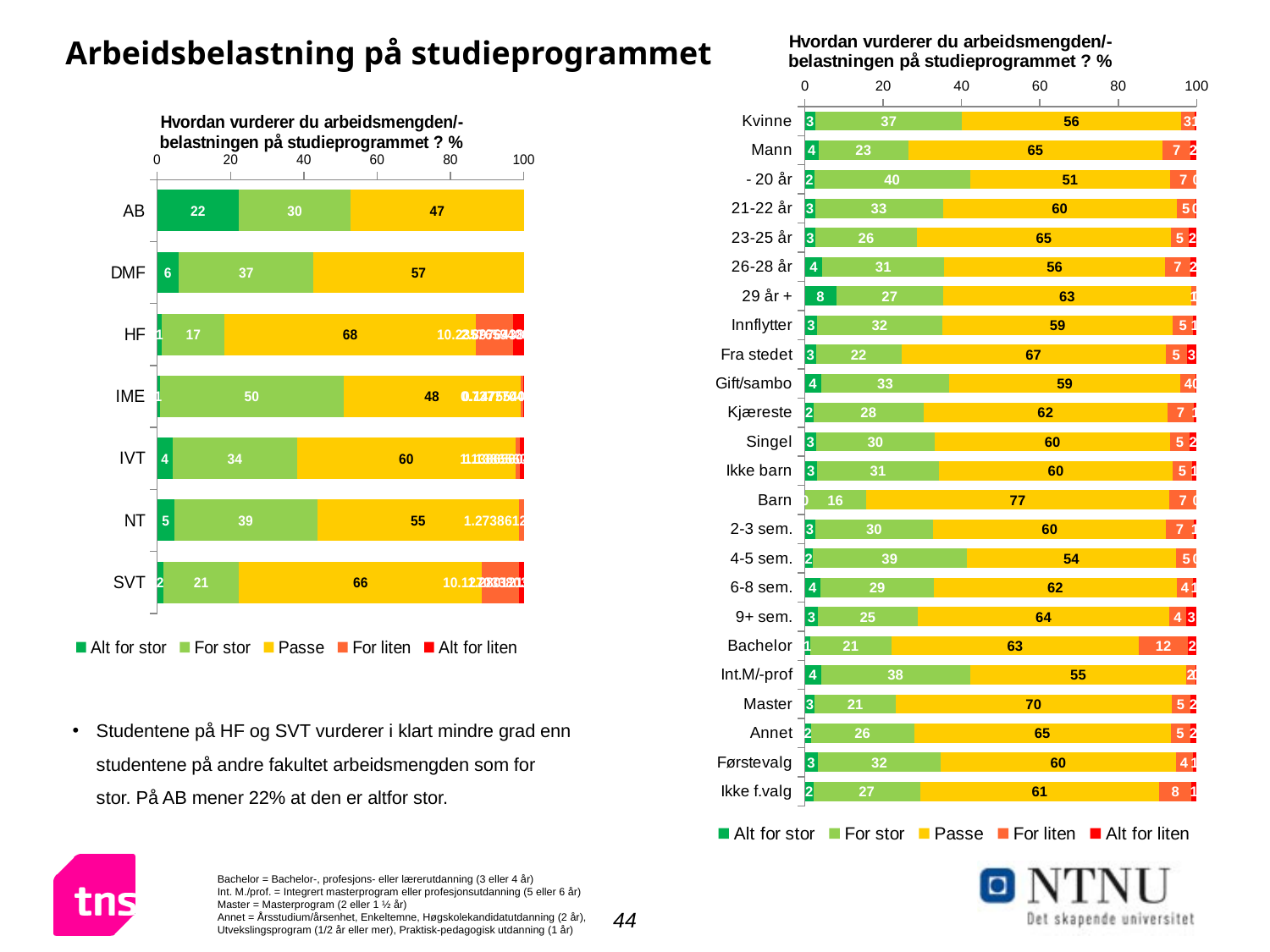
In the left chart (faculties), what is the difference between the 'Passe' values for SVT and AB? 19 In the right chart (demographics), which category has the highest 'Passe' value? Barn In the left chart (faculties), what is the 'Passe' value for HF? 68 In the left chart (faculties), which category has the highest 'Alt for stor' value? AB How many series does the legend of the right chart list? 5 In the right chart (demographics), what is the 'For liten' value for Bachelor? 12 In the right chart (demographics), which is larger: the 'For stor' value for Kvinne or for Mann? Kvinne In the left chart (faculties), how many categories are shown on the vertical axis? 7 What kind of chart is the left chart (faculties)? Stacked bar chart In the left chart (faculties), what is the 'Alt for stor' value for AB? 22 In the right chart (demographics), what is the 'Passe' value for Barn? 77 In the left chart (faculties), which category has the highest 'For stor' value? IME